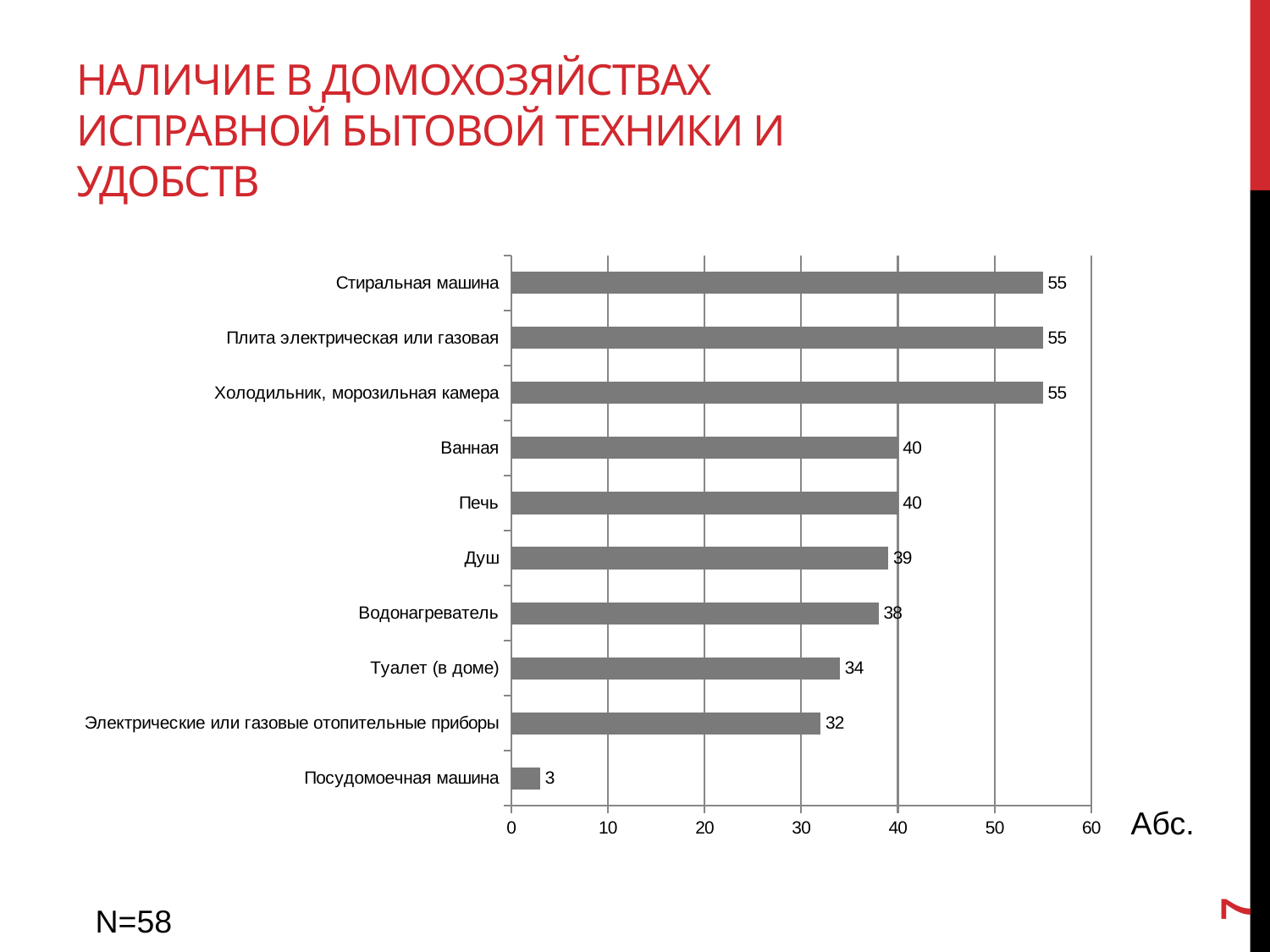
What is the value for Посудомоечная машина? 3 What is the difference between the values for Стиральная машина and Посудомоечная машина? 52 Is the value for Печь greater or less than 30? greater What kind of chart is shown on the slide? bar chart Which is larger, the value for Душ or the value for Электрические или газовые отопительные приборы? Душ How many categories are shown in the chart? 10 What is the value for Водонагреватель? 38 What is the sample size (N) stated on the slide? N=58 Which category has the lowest value? Посудомоечная машина What is the difference between the values for Ванная and Туалет (в доме)? 6 What is the value for Туалет (в доме)? 34 What is the value for Душ? 39